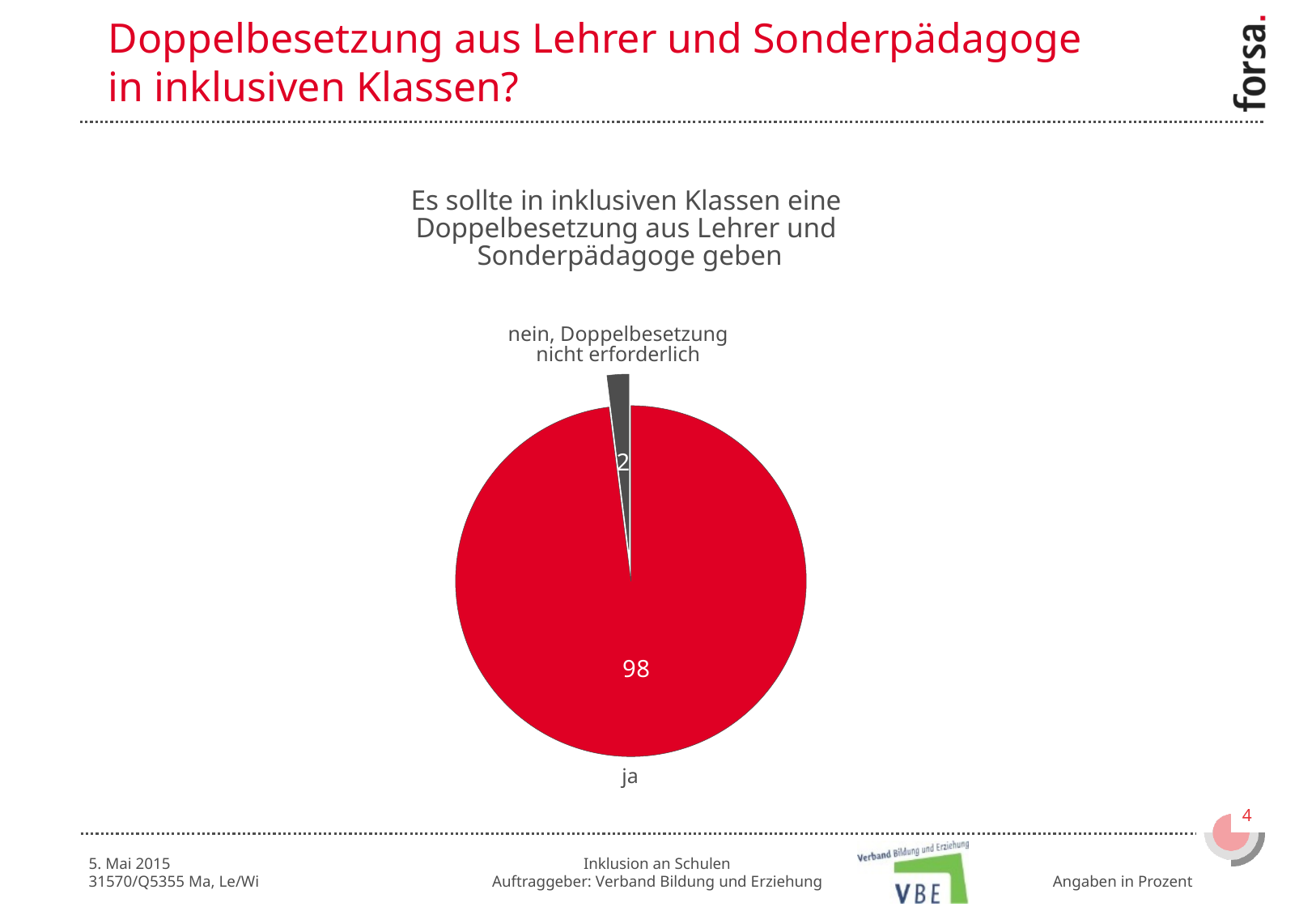
What share of the pie does the "ja" slice represent? 98% What is the value for "ja"? 98 Which slice is the largest? ja What is the value for "nein, Doppelbesetzung nicht erforderlich"? 2 What is the total of the two slice values? 100 Which is larger, the value for "ja" or the value for "nein, Doppelbesetzung nicht erforderlich"? ja What is the difference between the values for "ja" and "nein, Doppelbesetzung nicht erforderlich"? 96 What kind of chart is shown on the slide? pie chart What colour is the "ja" slice? red What is the title of the chart? Es sollte in inklusiven Klassen eine Doppelbesetzung aus Lehrer und Sonderpädagoge geben How many slices does the pie chart have? 2 Which slice is the smallest? nein, Doppelbesetzung nicht erforderlich